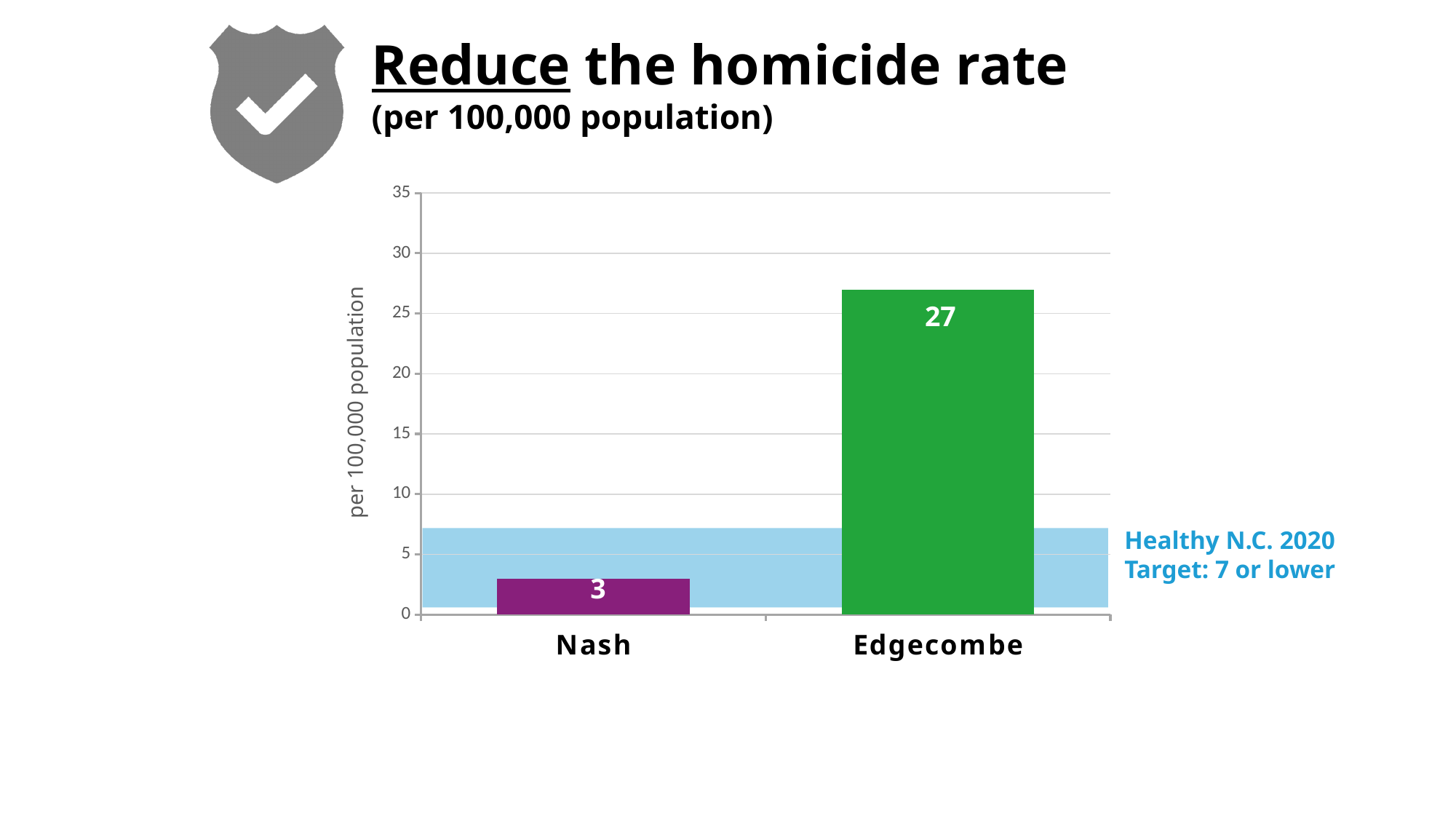
Which county has the higher homicide rate? Edgecombe What is the label on the vertical axis of the chart? per 100,000 population What is the Healthy N.C. 2020 target for the homicide rate? 7 or lower Which county has the lower homicide rate? Nash What kind of chart is shown on the slide? Bar chart What is the homicide rate for Nash? 3 Is the value for Edgecombe greater or less than 25? greater What is the difference between the homicide rates of Edgecombe and Nash? 24 What is the homicide rate for Edgecombe? 27 Is the homicide rate for Nash greater or less than that for Edgecombe? less Is the value for Nash greater or less than 5? less How many counties are shown in the chart? 2